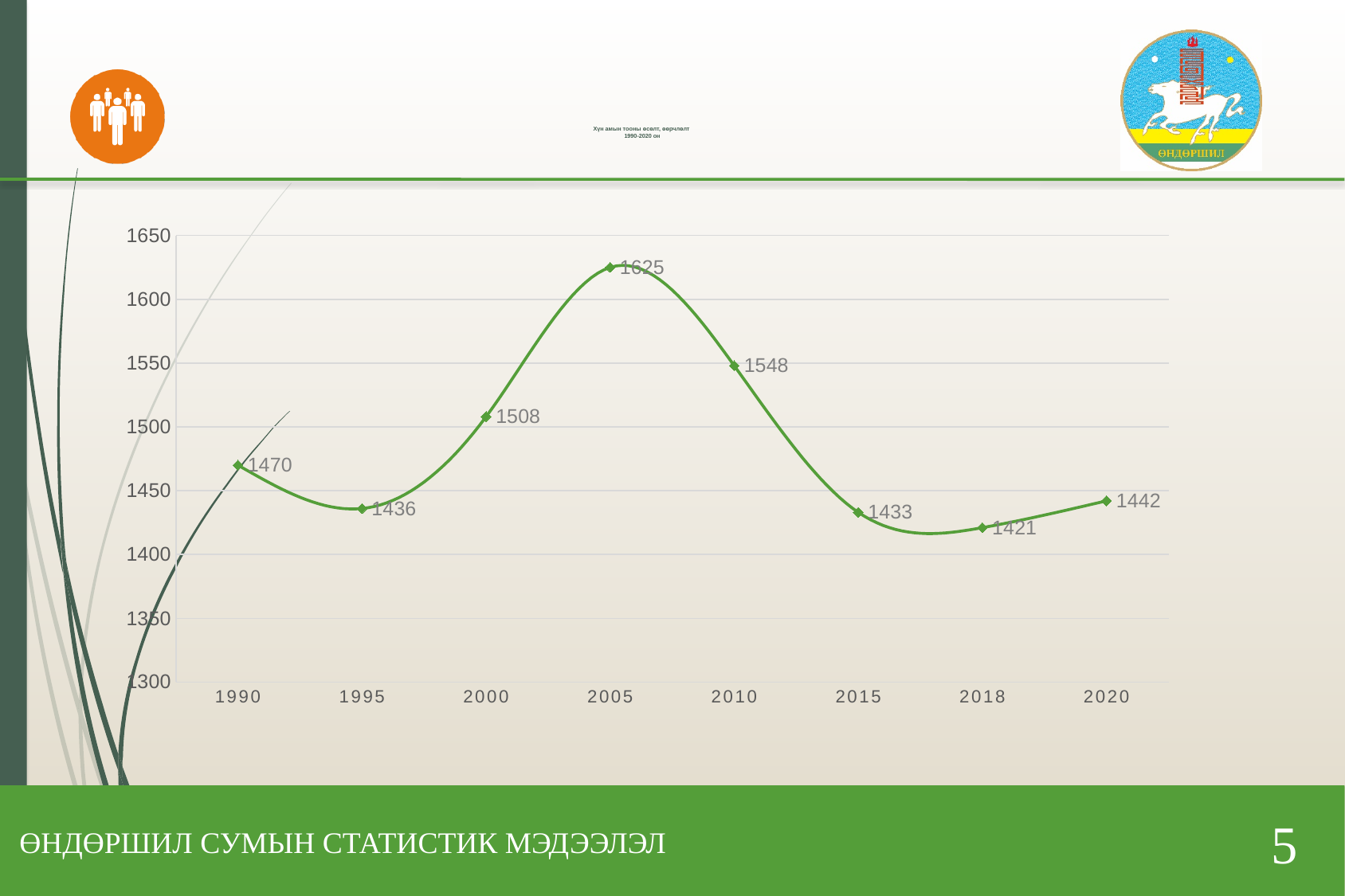
What is the value for 1990? 1470 What is the difference between the values for 2005 and 2010? 77 Does the value rise or fall from 2005 to 2015? fall What is the value for 2005? 1625 What is the value for 2018? 1421 Is the value for 2010 greater or less than 1500? greater Which year has the highest value? 2005 Which is larger, the value for 2000 or the value for 2015? 2000 What kind of chart is shown on the slide? line chart Which year has the lowest value? 2018 What is the difference between the values for 2020 and 2018? 21 How many years are plotted on the x axis? 8